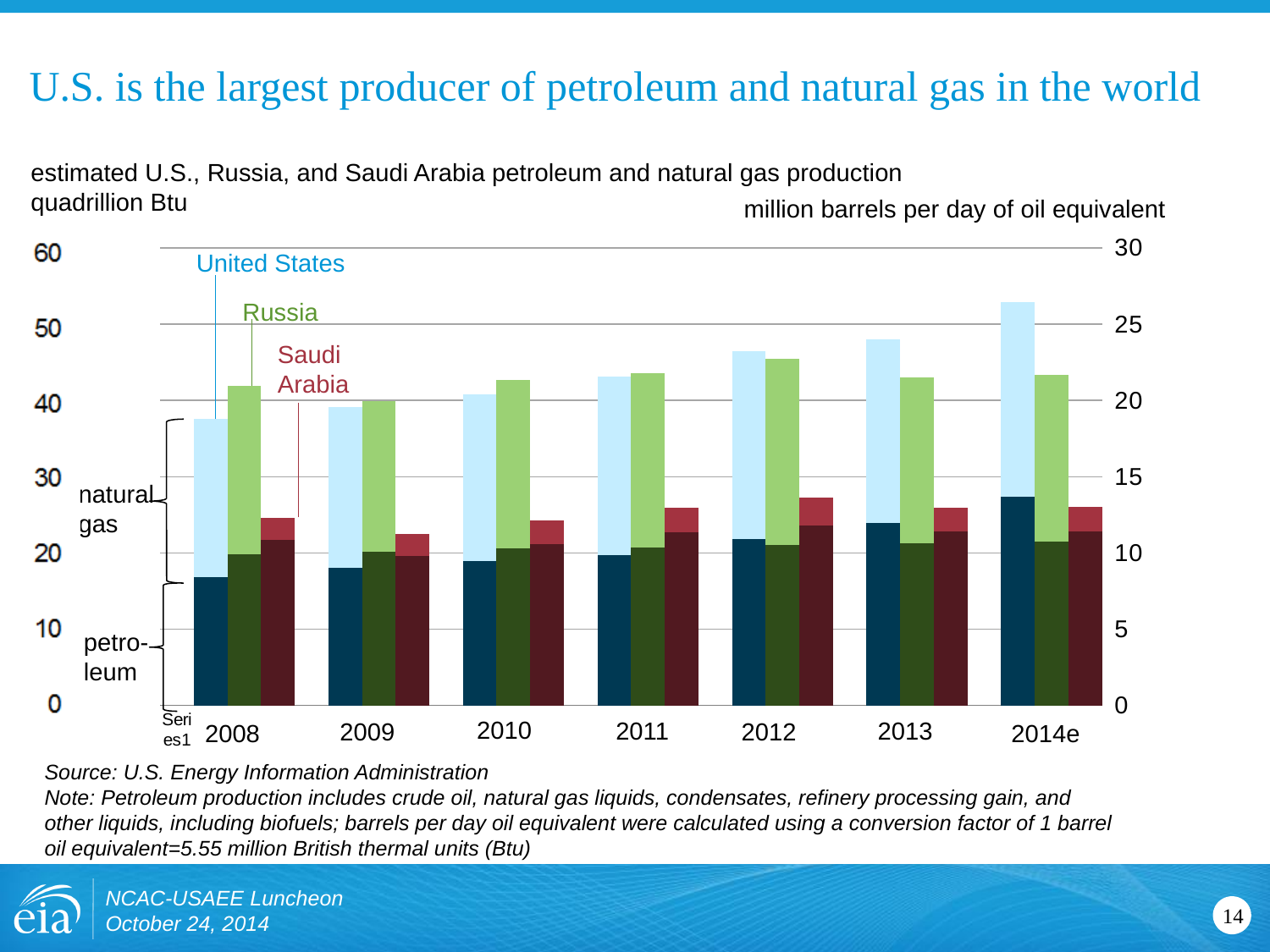
What kind of chart is shown on the slide? stacked bar chart Is the total Russia bar for 2012 greater or less than 40 quadrillion Btu? greater Which country has the tallest bar in 2014e? United States How many years are shown along the x axis of the chart? 7 Does the total United States bar rise or fall from 2008 to 2014e? rise In 2014e, which bar is taller: United States or Russia? United States In 2008, which bar is taller: United States or Russia? Russia Is the total United States bar for 2014e greater or less than 50 quadrillion Btu? greater Is the total Saudi Arabia bar for 2008 greater or less than 30 quadrillion Btu? less Which country has the shortest bar in 2008? Saudi Arabia In which year is the United States bar the tallest? 2014e What unit is shown on the left axis of the chart? quadrillion Btu